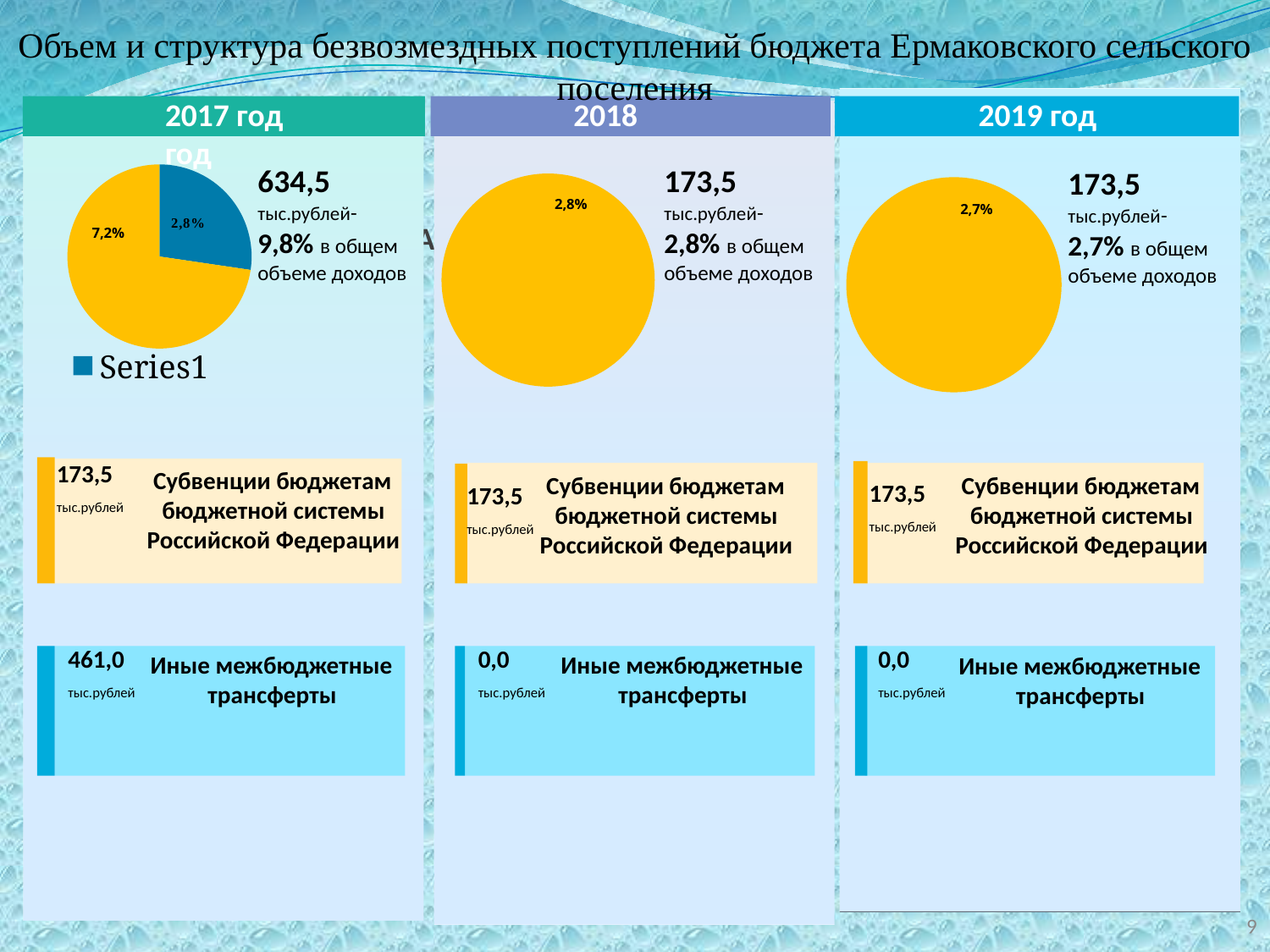
In the 2017 год pie chart, what value is labelled on the yellow slice? 7,2% In the 2017 год pie chart, what is the largest labelled value? 7,2% What kind of chart is shown under the 2017 год heading? pie chart In the 2017 год pie chart, how many slices are there? 2 In the 2017 год pie chart, what is the difference between the yellow slice (7,2%) and the blue slice (2,8%)? 4,4% In the 2019 год pie chart, how many slices are visible? 1 In the 2019 год pie chart, what value is labelled on the pie? 2,7% In the 2017 год pie chart, which slice is larger, the yellow one or the blue one? the yellow one In the 2018 год pie chart, what value is labelled on the pie? 2,8% In the 2017 год pie chart, what is the smallest labelled value? 2,8% What legend entry is shown below the 2017 год pie chart? Series1 In the 2017 год pie chart, what value is labelled on the blue slice? 2,8%